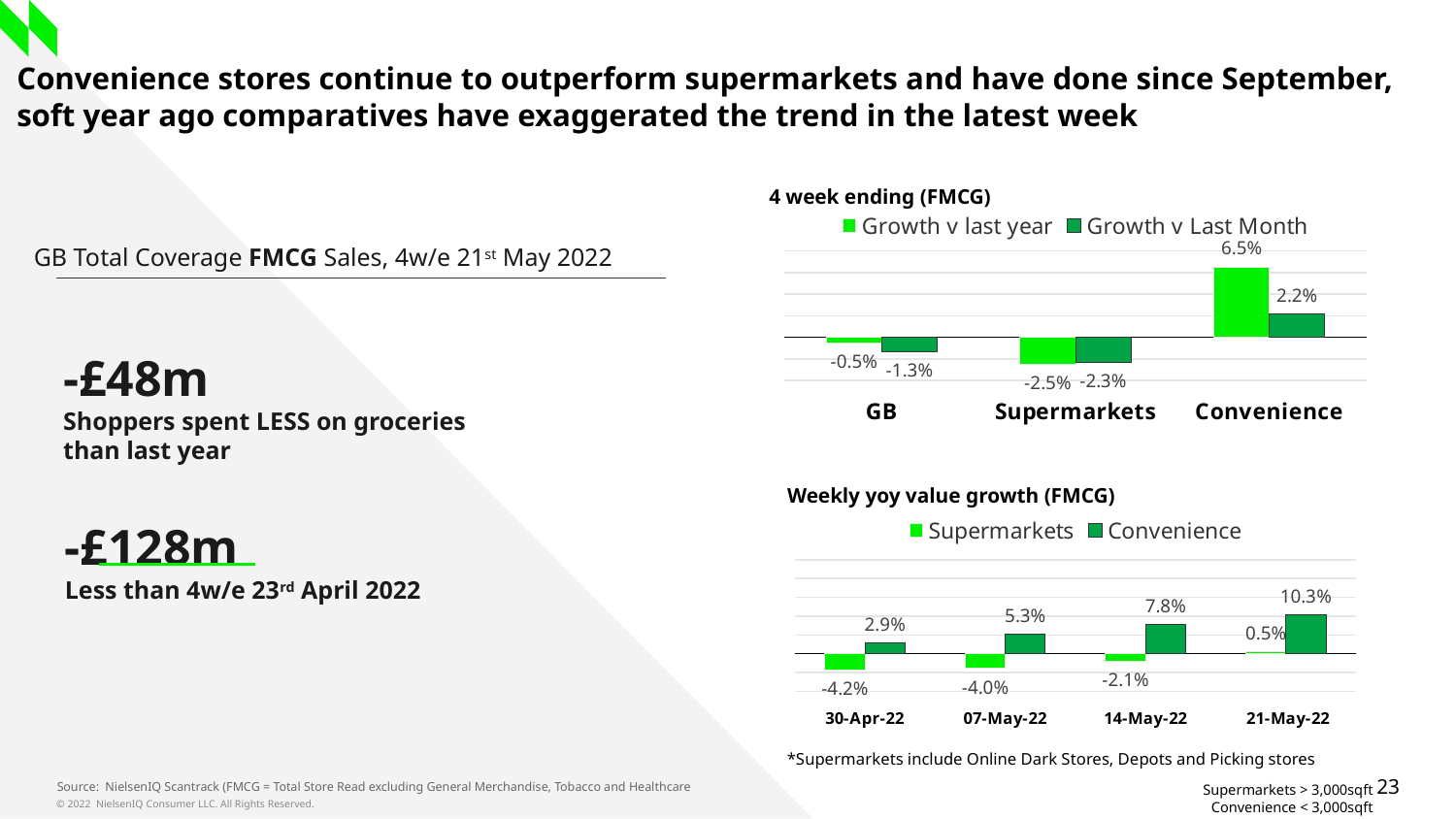
In the 'Weekly yoy value growth (FMCG)' chart, do the Convenience values rise or fall from 30-Apr-22 to 21-May-22? Rise In the 'Weekly yoy value growth (FMCG)' chart, what is the Supermarkets value for 30-Apr-22? -4.2% In the '4 week ending (FMCG)' chart, what is the Growth v last year value for Convenience? 6.5% How many series does the legend of the '4 week ending (FMCG)' chart list? 2 In the 'Weekly yoy value growth (FMCG)' chart, what is the Convenience value for 14-May-22? 7.8% In the '4 week ending (FMCG)' chart, which category has the lowest Growth v last year value? Supermarkets In the 'Weekly yoy value growth (FMCG)' chart, how many dates are shown on the x axis? 4 In the 'Weekly yoy value growth (FMCG)' chart, which is larger for 21-May-22: Supermarkets or Convenience? Convenience In the '4 week ending (FMCG)' chart, what is the difference between the Growth v last year values for Convenience and Supermarkets? 9.0 percentage points In the 'Weekly yoy value growth (FMCG)' chart, what is the difference between the Convenience and Supermarkets values for 07-May-22? 9.3 percentage points What type of chart is the '4 week ending (FMCG)' chart? Bar chart In the '4 week ending (FMCG)' chart, what is the Growth v Last Month value for GB? -1.3%